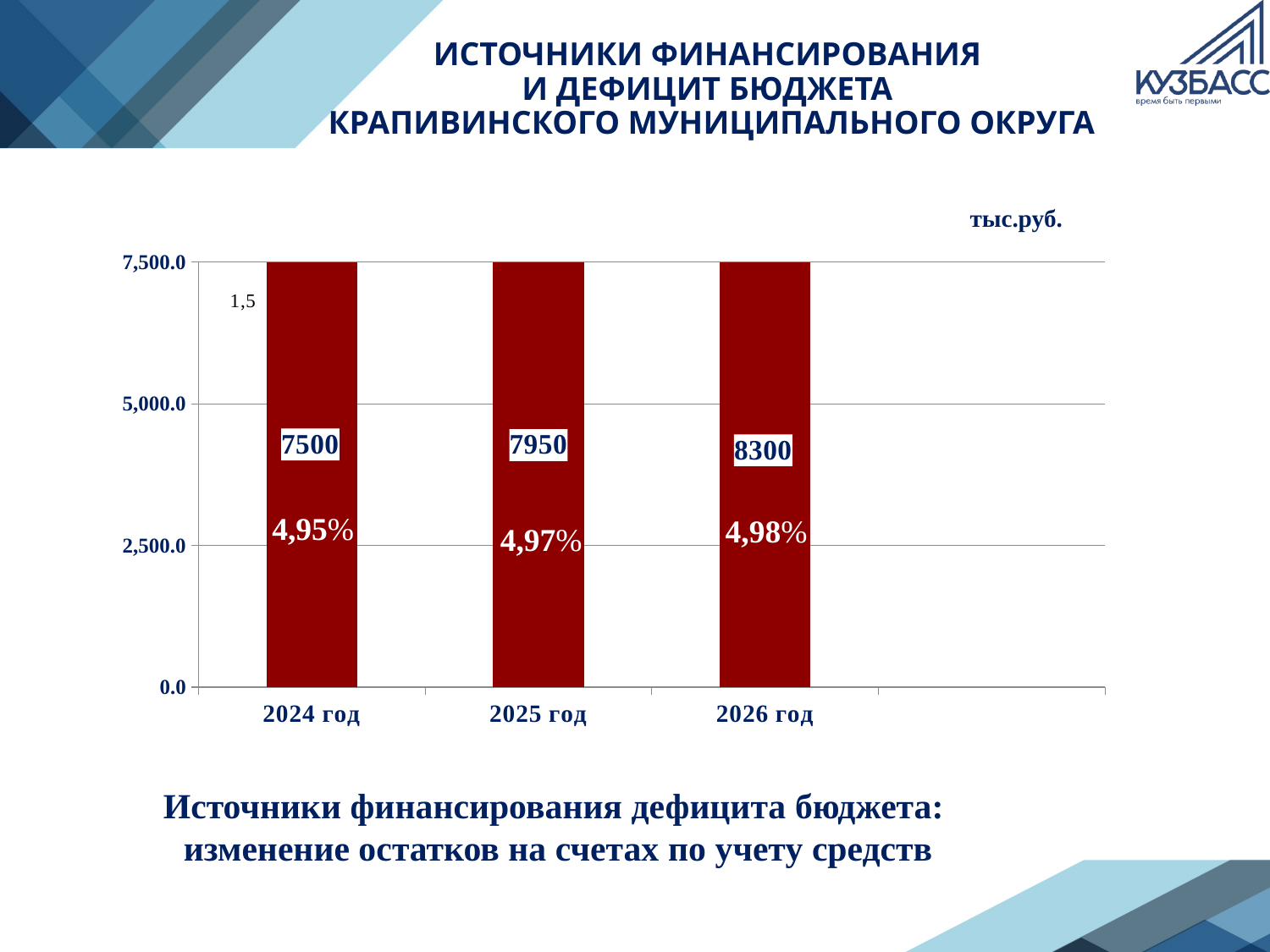
What is the value for 2025 год? 7950 Which year has the lowest value? 2024 год How many years are shown on the x axis? 3 Is the value for 2025 год greater or less than 5,000.0? greater What is the value for 2024 год? 7500 What kind of chart is shown on the slide? bar chart What is the value for 2026 год? 8300 What is the difference between the values for 2026 год and 2024 год? 800 What percentage is shown on the bar for 2026 год? 4,98% What percentage is shown on the bar for 2024 год? 4,95% Which is larger, the value for 2025 год or the value for 2024 год? 2025 год Which year has the highest value? 2026 год